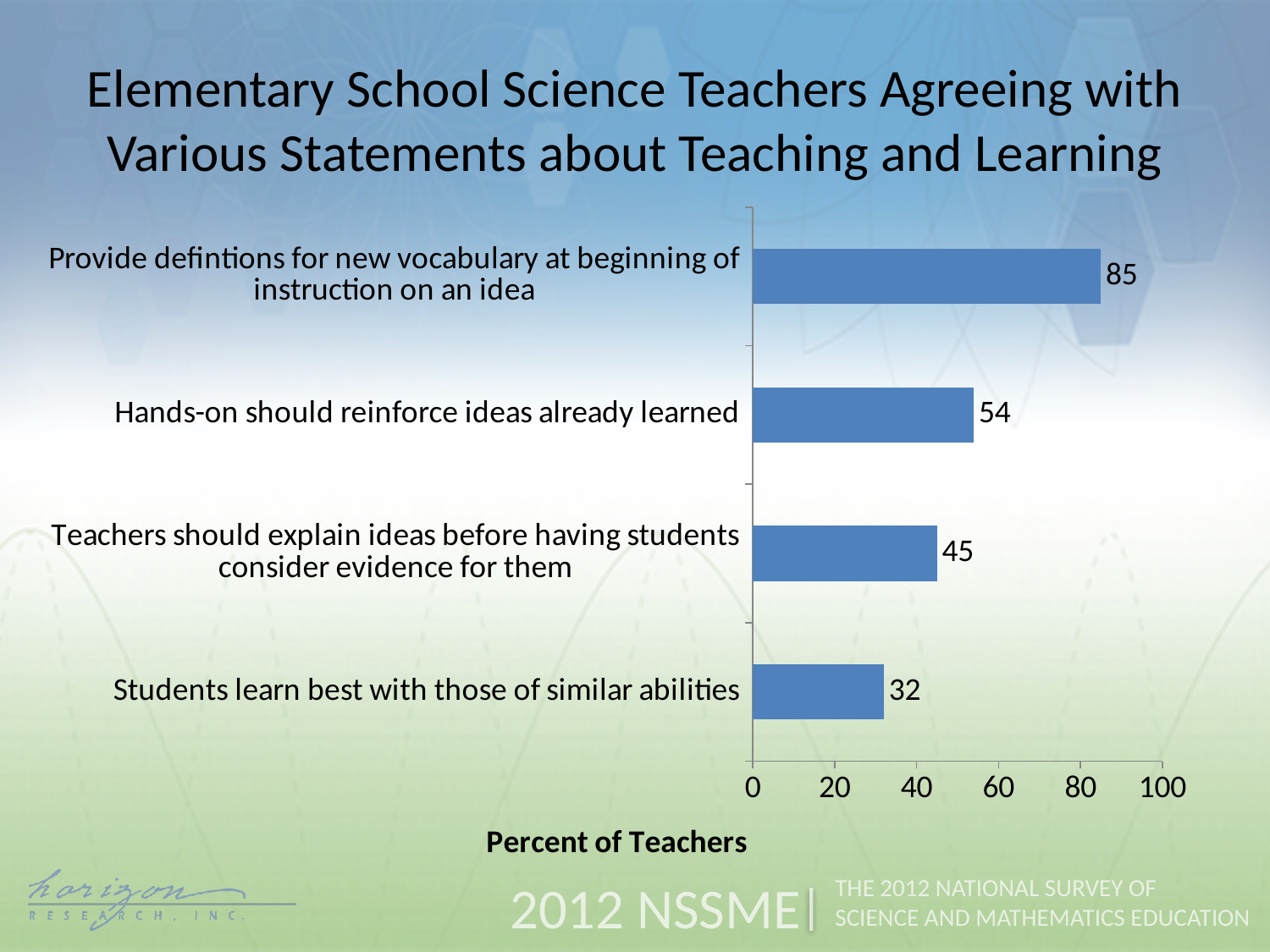
Which is larger: the value for "Hands-on should reinforce ideas already learned" or for "Teachers should explain ideas before having students consider evidence for them"? Hands-on should reinforce ideas already learned What is the difference between the values for "Hands-on should reinforce ideas already learned" and "Teachers should explain ideas before having students consider evidence for them"? 9 What is the value for "Hands-on should reinforce ideas already learned"? 54 What percent of teachers agree with "Provide defintions for new vocabulary at beginning of instruction on an idea"? 85 What is the value for "Teachers should explain ideas before having students consider evidence for them"? 45 How many statements (categories) are shown in the chart? 4 What kind of chart is shown on the slide? Bar chart What is the value for "Students learn best with those of similar abilities"? 32 What is the difference between the values for "Provide defintions for new vocabulary at beginning of instruction on an idea" and "Students learn best with those of similar abilities"? 53 Which statement has the highest percent of teachers agreeing? Provide defintions for new vocabulary at beginning of instruction on an idea Which statement has the lowest percent of teachers agreeing? Students learn best with those of similar abilities What is the label of the horizontal axis? Percent of Teachers